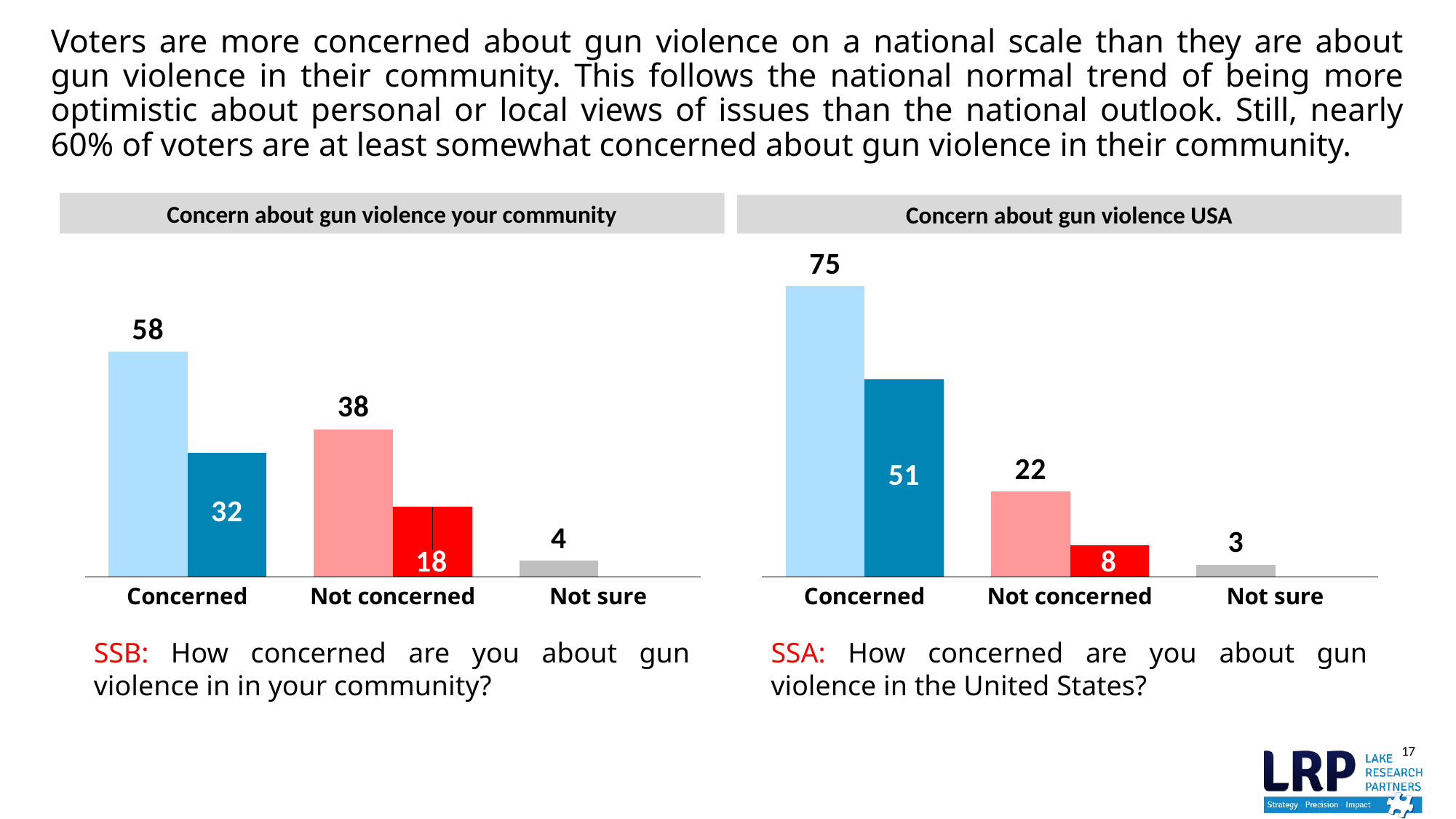
In the 'Concern about gun violence USA' chart, what is the difference between the light red Not concerned value (22) and the red Not concerned value (8)? 14 In the 'Concern about gun violence your community' chart, what is the difference between the light blue Concerned value (58) and the light red Not concerned value (38)? 20 In the 'Concern about gun violence USA' chart, what is the value labelled above the light blue bar for Concerned? 75 In the 'Concern about gun violence your community' chart, which category has the lowest value? Not sure In the 'Concern about gun violence your community' chart, what is the value labelled above the light blue bar for Concerned? 58 In the 'Concern about gun violence USA' chart, what is the value for Not sure? 3 In the 'Concern about gun violence USA' chart, what value is printed inside the dark blue bar for Concerned? 51 What kind of chart is the 'Concern about gun violence your community' chart? Bar chart Which is larger: the light blue Concerned value in the 'Concern about gun violence your community' chart or the light blue Concerned value in the 'Concern about gun violence USA' chart? Concern about gun violence USA In the 'Concern about gun violence USA' chart, which category has the highest value? Concerned In the 'Concern about gun violence your community' chart, what value is printed inside the red bar for Not concerned? 18 How many categories are shown on the x axis of the 'Concern about gun violence USA' chart? 3